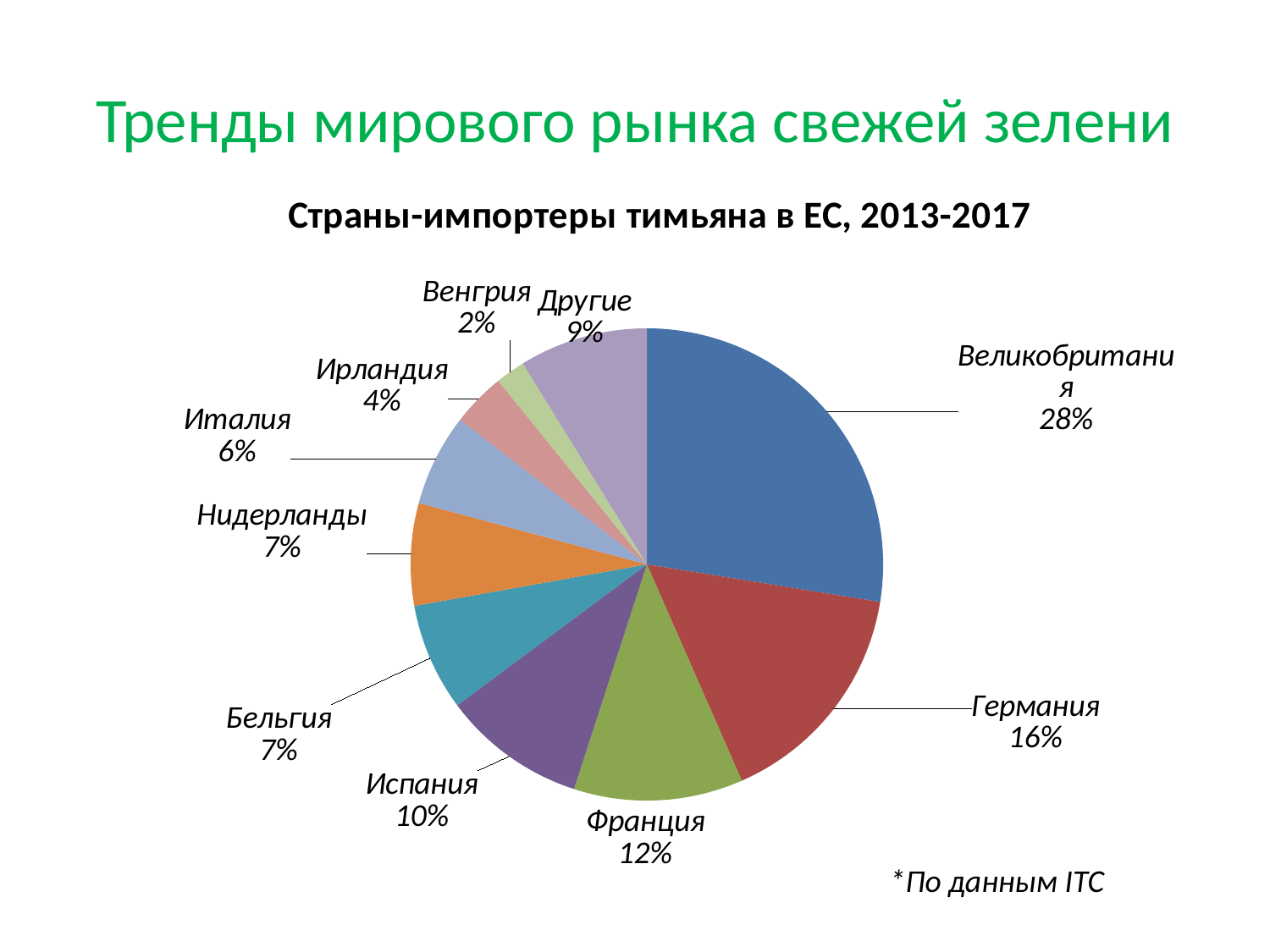
What share of the pie does Великобритания have? 28% What kind of chart is shown on the slide? Pie chart What is the value shown for Другие? 9% How many slices does the pie chart have? 10 What is the difference between the shares of Великобритания and Германия? 12% Which country has the largest slice of the pie? Великобритания What is the value shown for Испания? 10% Which is larger, the share of Испания or the share of Италия? Испания Which category has the smallest slice of the pie? Венгрия What is the value shown for Франция? 12% What is the value shown for Германия? 16% What is the title of the chart? Страны-импортеры тимьяна в ЕС, 2013-2017